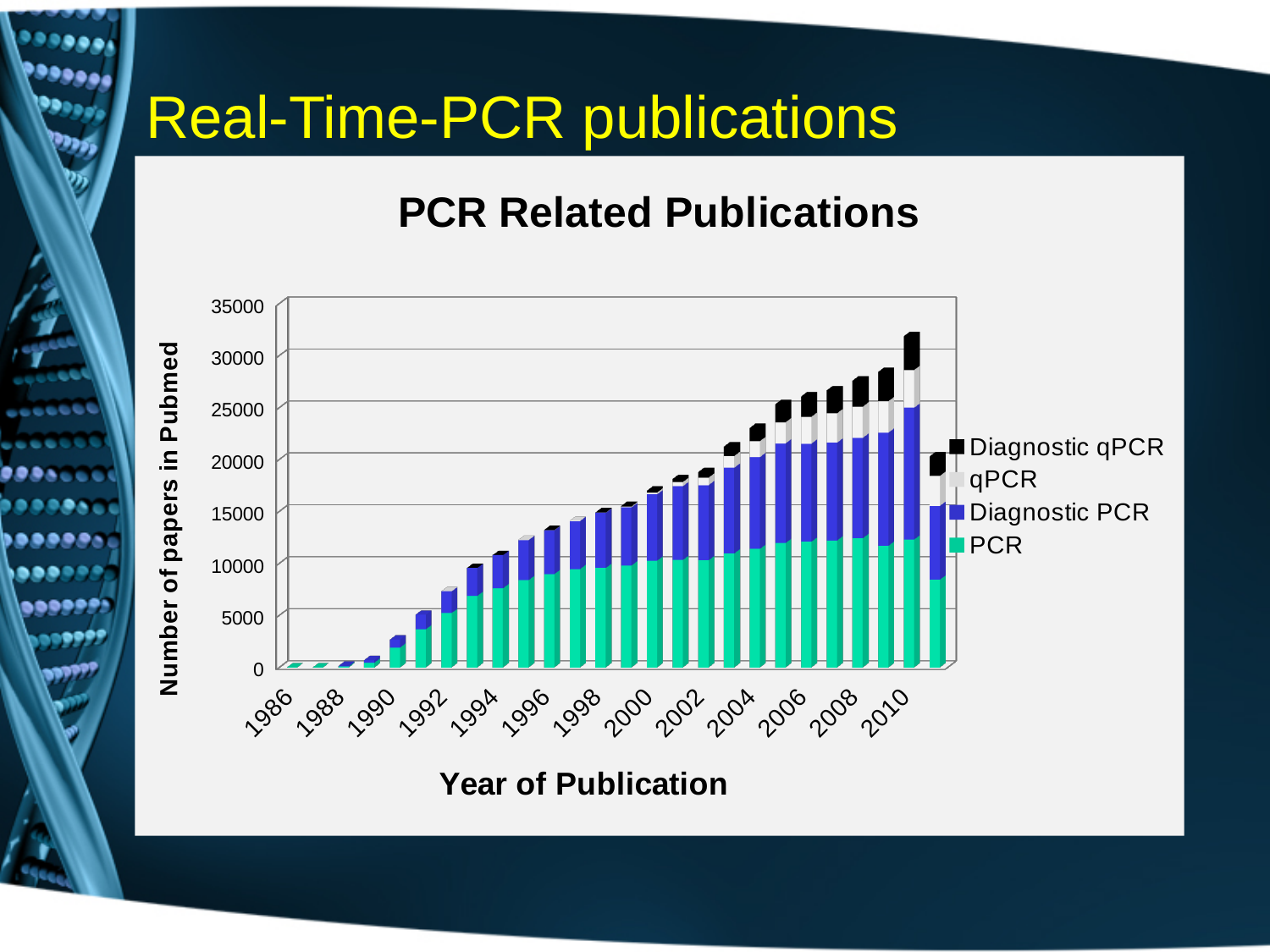
Is the total stacked value for 2006 greater or less than 20000? greater Is the total stacked value for 2010 greater or less than 25000? greater Is the total stacked value for 1990 greater or less than 5000? less How many series does the legend list? 4 What is the title of the chart? PCR Related Publications Which year has the shortest stacked bar? 1986 What is the label of the vertical axis? Number of papers in Pubmed Do the total publication counts generally rise or fall from 1986 to 2010? rise What kind of chart is shown on the slide? stacked bar chart Which year has the tallest stacked bar? 2010 Which year has the larger total stacked bar, 1994 or 2004? 2004